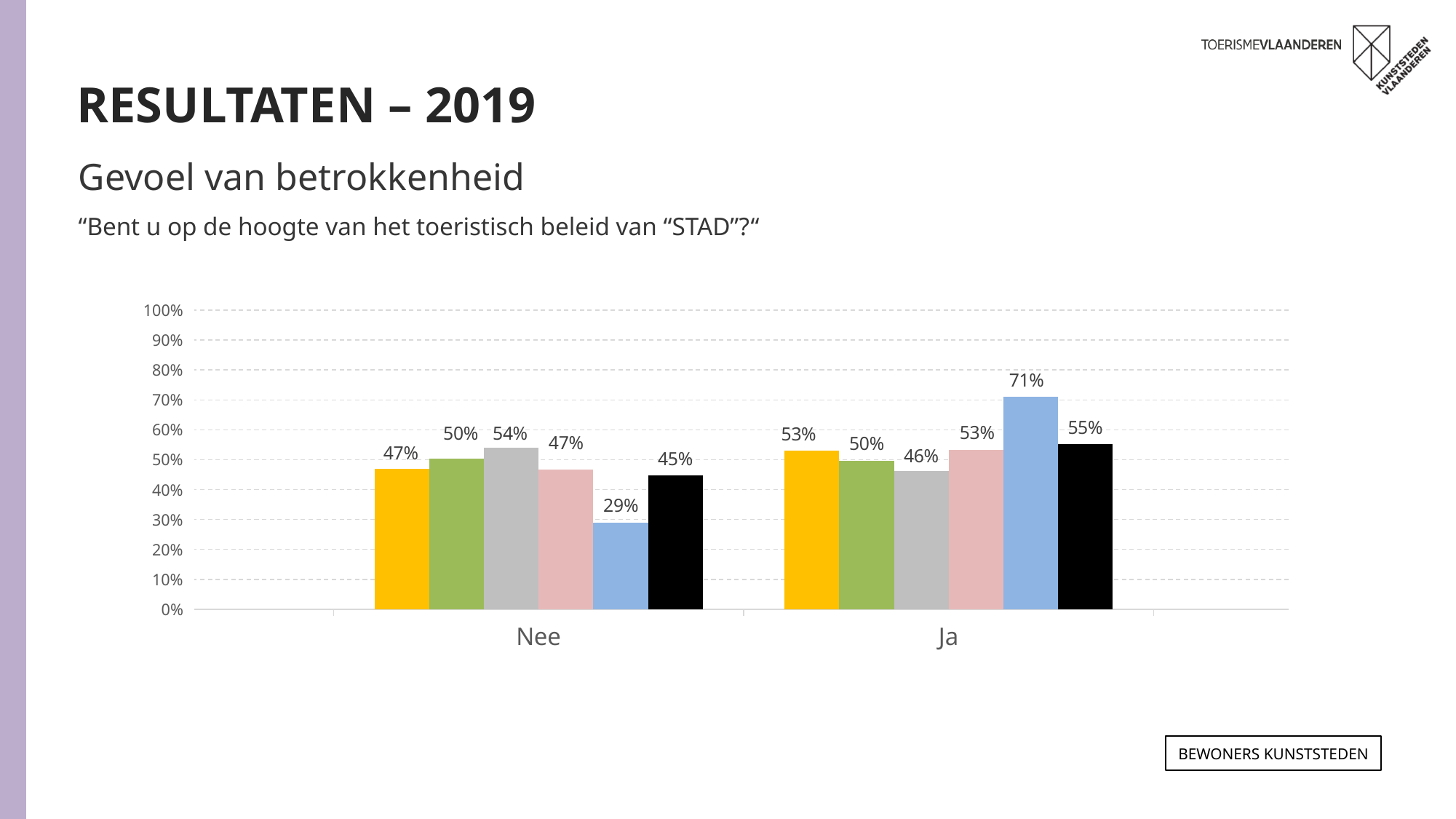
What is the value of the grey bar for the category "Nee"? 54% What is the value of the blue bar for the category "Ja"? 71% Is the value of the blue bar for "Ja" greater or less than 60%? greater Which bar in the "Ja" group has the highest value? the blue bar (71%) What is the value of the black bar for the category "Ja"? 55% What is the value of the blue bar for the category "Nee"? 29% What kind of chart is shown on the slide? bar chart Which is larger: the grey bar for "Nee" or the grey bar for "Ja"? the grey bar for "Nee" (54%) How many bars are shown for each category on the chart? 6 How many categories are shown on the x axis of the chart? 2 What is the difference between the blue bar for "Ja" and the blue bar for "Nee"? 42 percentage points Which bar in the "Nee" group has the lowest value? the blue bar (29%)